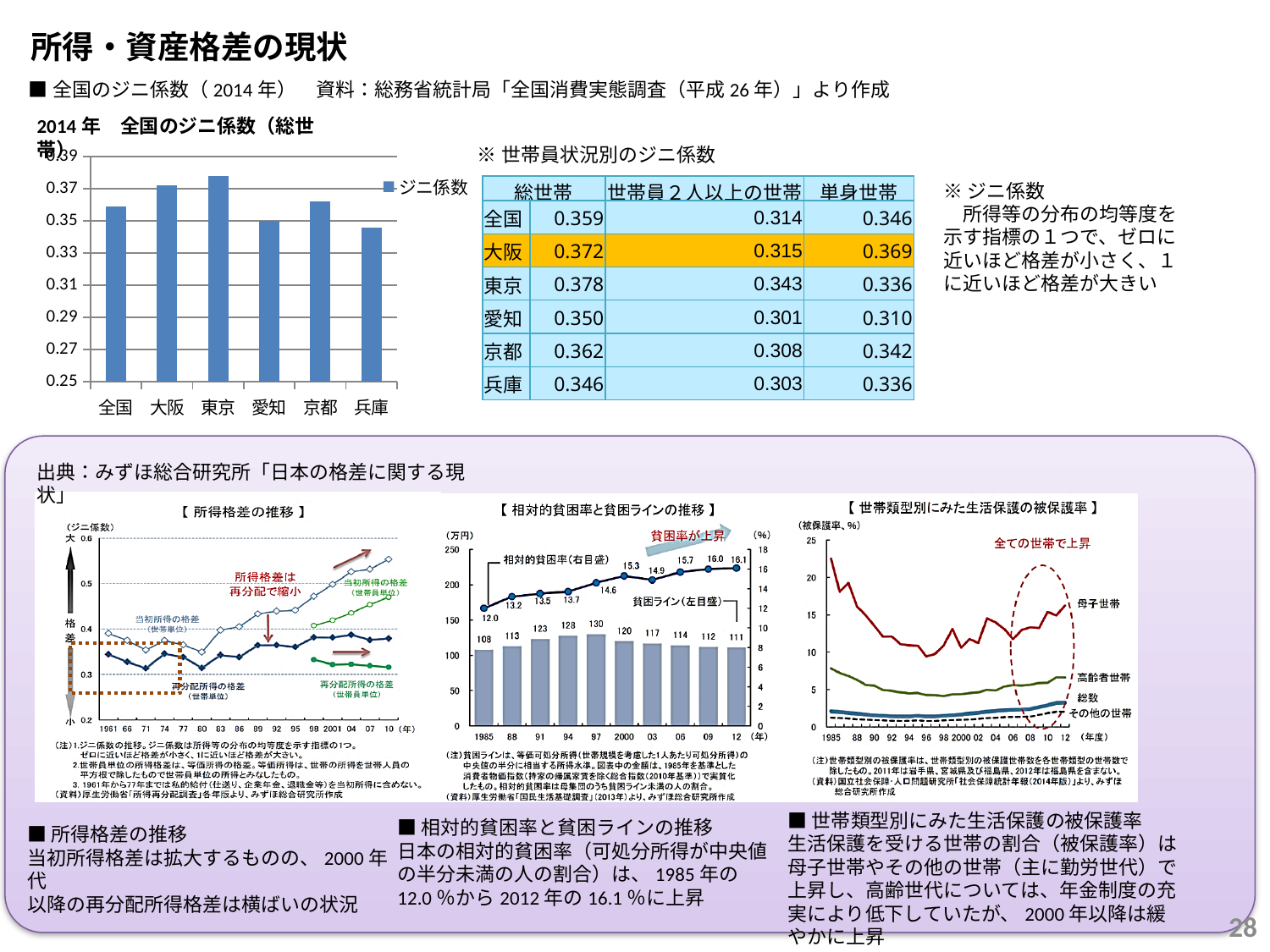
In the '相対的貧困率と貧困ラインの推移' chart at the bottom centre, what is the difference between the 相対的貧困率 values for 2012 (16.1) and 1985 (12.0)? 4.1 In the '2014年 全国のジニ係数（総世帯）' bar chart, which category has the highest value? 東京 In the '相対的貧困率と貧困ラインの推移' chart at the bottom centre, what is the highest 貧困ライン bar value labelled? 130 In the '2014年 全国のジニ係数（総世帯）' bar chart, is the value for 京都 greater or less than 0.35? greater In the '2014年 全国のジニ係数（総世帯）' bar chart, is the value for 東京 greater or less than 0.37? greater What is the legend entry of the '2014年 全国のジニ係数（総世帯）' bar chart? ジニ係数 How many series does the legend of the '2014年 全国のジニ係数（総世帯）' bar chart list? 1 In the '2014年 全国のジニ係数（総世帯）' bar chart, which category has the lowest value? 兵庫 What type of chart is the '2014年 全国のジニ係数（総世帯）' chart at the top left of the slide? bar chart In the '相対的貧困率と貧困ラインの推移' chart at the bottom centre, what is the 相対的貧困率 value labelled for 1985? 12.0 How many categories are shown on the x axis of the '2014年 全国のジニ係数（総世帯）' bar chart? 6 In the '2014年 全国のジニ係数（総世帯）' bar chart, which is larger, the value for 大阪 or the value for 愛知? 大阪